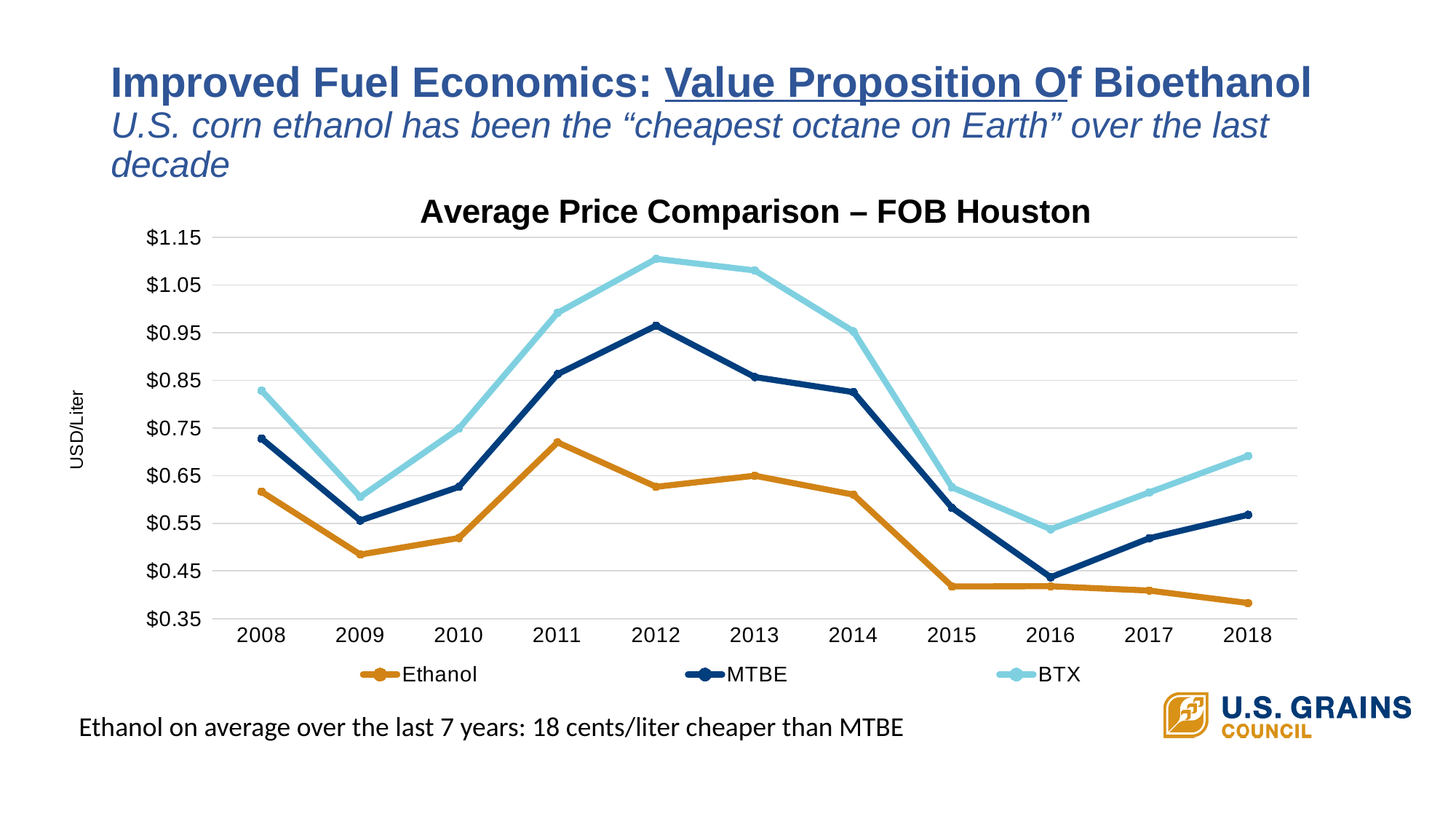
What is the title of the chart? Average Price Comparison – FOB Houston What kind of chart is shown on the slide? line chart In which year does the Ethanol series reach its highest value? 2011 In which year is the MTBE series at its lowest value? 2016 How many series does the legend list? 3 Does the Ethanol series rise or fall from 2014 to 2018? fall In which year is the Ethanol series at its lowest value? 2018 How many years are plotted along the x axis? 11 Is the value for Ethanol in 2009 greater or less than $0.55? less Is the value for BTX in 2012 greater or less than $1.05? greater In which year does the BTX series reach its highest value? 2012 In 2012, which is higher: MTBE or Ethanol? MTBE